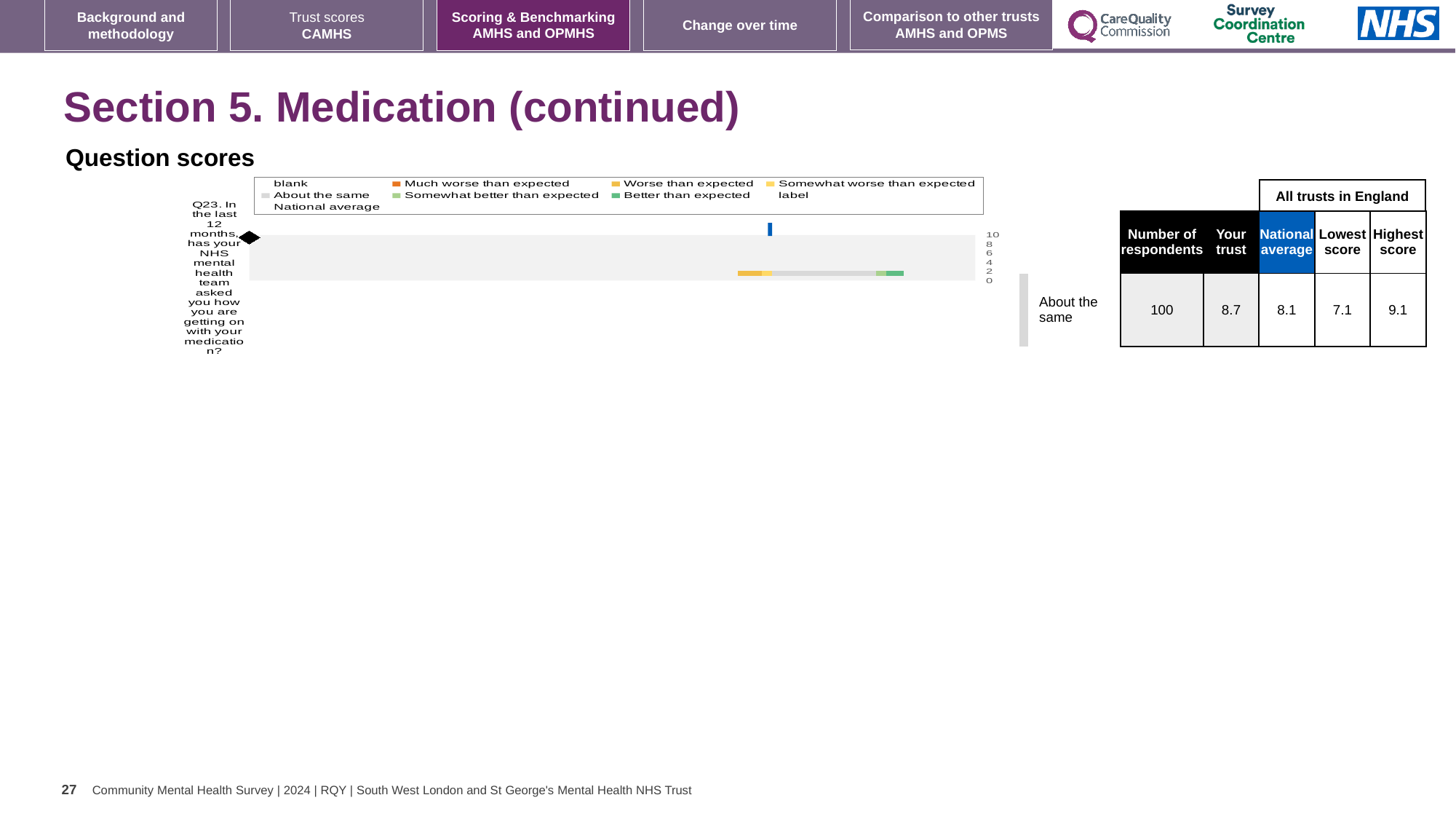
According to the table beside the chart, which is larger for Q23: the 'Your trust' score or the national average? Your trust How many question categories are plotted on the chart? 1 According to the table beside the chart, what is the number of respondents for Q23? 100 What kind of chart is shown under 'Question scores'? bar chart According to the table beside the chart, what is the national average score for Q23? 8.1 According to the table beside the chart, what is the 'Your trust' score for Q23? 8.7 What colour does the legend use for 'Much worse than expected'? orange What benchmark category is shown next to the chart for Q23? About the same How many entries does the chart's legend list? 9 Which question is plotted on the chart? Q23. In the last 12 months, has your NHS mental health team asked you how you are getting on with your medication? What is the highest tick value shown on the chart's axis? 10 According to the table beside the chart, what is the difference between the highest score and the lowest score for Q23? 2.0